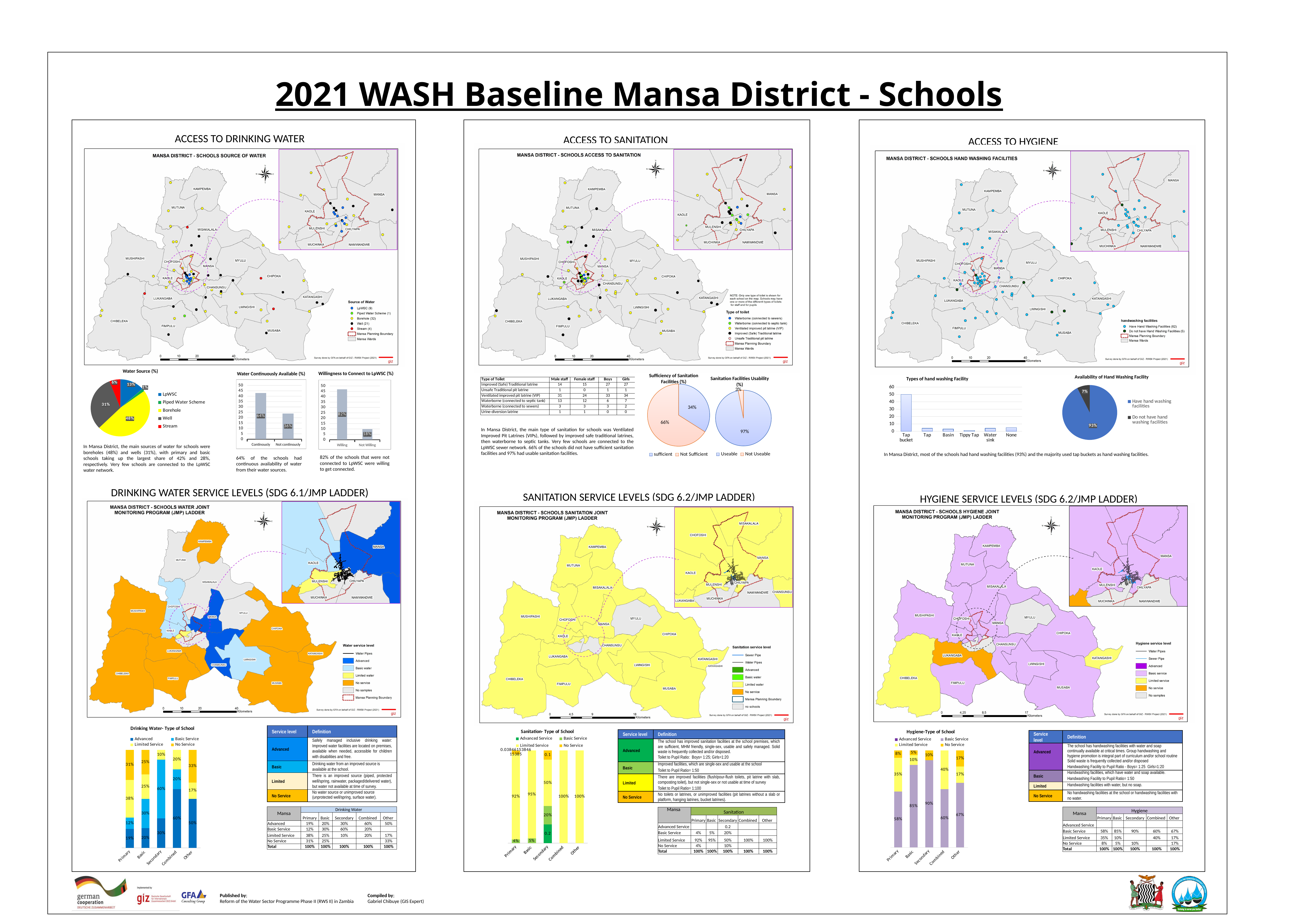
In the 'Drinking Water- Type of School' stacked bar chart, what is the 'Advanced' value for Combined schools? 60% In the 'Types of hand washing Facility' bar chart, how many facility categories are shown on the x axis? 6 In the 'Water Source (%)' pie chart, which water source has the largest share? Borehole In the 'Sanitation Facilities Usability (%)' pie chart, what share is 'Useable'? 97% In the 'Water Source (%)' pie chart, what is the share for Well? 31% In the 'Water Source (%)' pie chart, what share of schools use boreholes? 48% In the 'Types of hand washing Facility' bar chart, is the value for 'Tap bucket' greater or less than 40? greater In the 'Sufficiency of Sanitation Facilities (%)' pie chart, what share is 'Not Sufficient'? 66% In the 'Water Continuously Available (%)' bar chart, what is the value for 'Continuously'? 64% In the 'Willingness to Connect to LpWSC (%)' bar chart, what is the difference between 'Willing' and 'Not Willing'? 64% In the 'Availability of Hand Washing Facility' pie chart, what share of schools have hand washing facilities? 93% In the 'Types of hand washing Facility' bar chart, which facility type has the highest value? Tap bucket